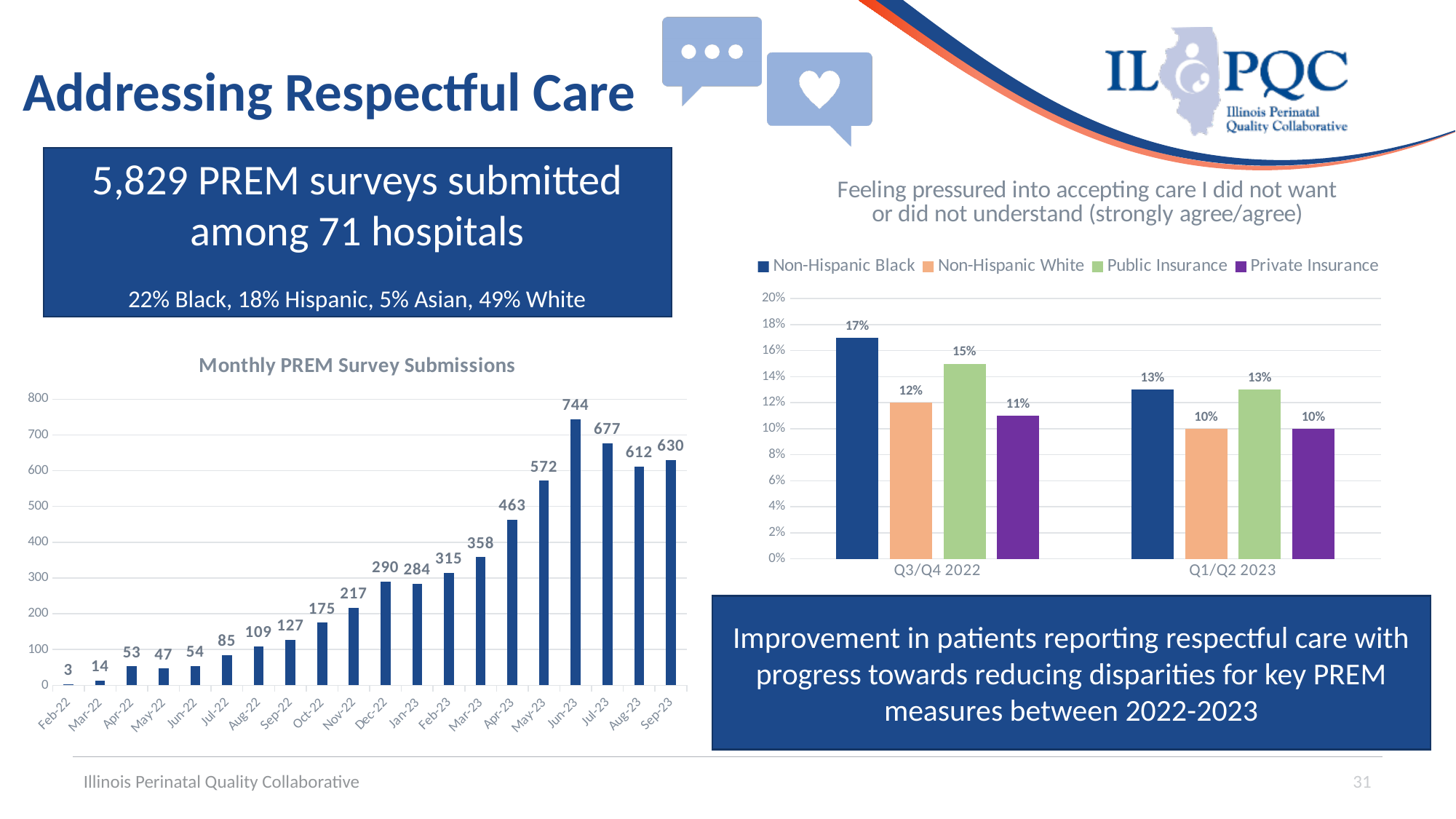
In the 'Feeling pressured into accepting care' chart, what is the difference between Non-Hispanic Black and Non-Hispanic White in Q3/Q4 2022? 5% In the Monthly PREM Survey Submissions chart, which is larger, the value for Aug-23 or Sep-23? Sep-23 In the Monthly PREM Survey Submissions chart, what is the difference between the values for Jun-23 and Jul-23? 67 In the Monthly PREM Survey Submissions chart, what is the value for Dec-22? 290 What kind of chart is the Monthly PREM Survey Submissions chart? Bar chart In the 'Feeling pressured into accepting care' chart, what is the value for Private Insurance in Q1/Q2 2023? 10% In the Monthly PREM Survey Submissions chart, what is the value for Jun-23? 744 In the Monthly PREM Survey Submissions chart, which month has the highest number of submissions? Jun-23 In the 'Feeling pressured into accepting care' chart, how many series does the legend list? 4 In the 'Feeling pressured into accepting care' chart, what is the value for Non-Hispanic Black in Q3/Q4 2022? 17% In the Monthly PREM Survey Submissions chart, how many months are shown on the x axis? 20 In the Monthly PREM Survey Submissions chart, which month has the lowest number of submissions? Feb-22